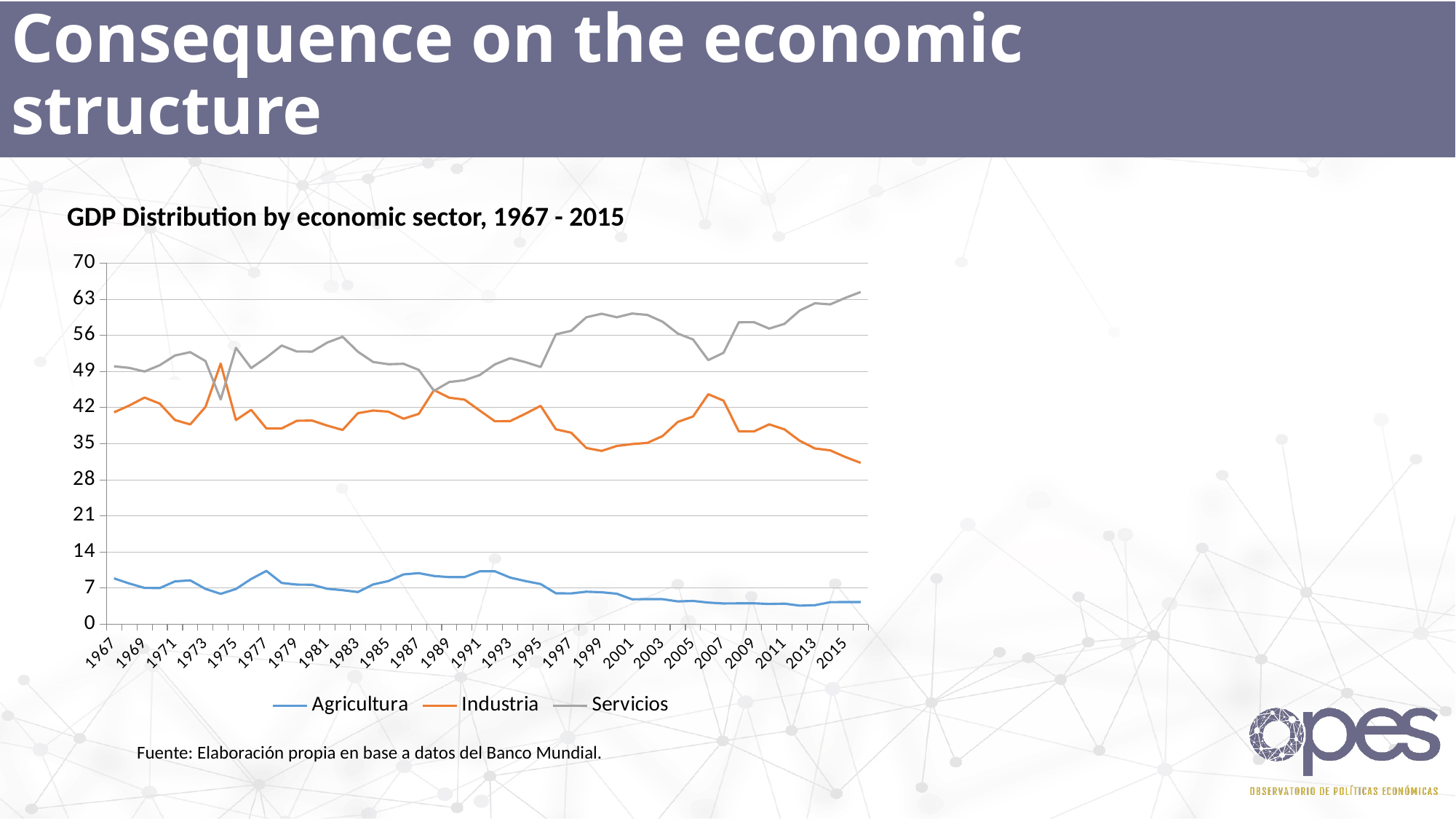
What is the title of the chart? GDP Distribution by economic sector, 1967 - 2015 What kind of chart is shown on the slide? line chart Is the value for Industria in 2015 greater or less than 35? less Which series has the highest value in 2015? Servicios Which series is shown in orange in the legend? Industria Is the value for Servicios in 2015 greater or less than 56? greater Does the Agricultura line generally rise or fall from 1991 to 2015? fall In 2007, which is larger: Industria or Servicios? Servicios How many series does the legend list? 3 Is the value for Agricultura in 2015 greater or less than 7? less Does the Servicios line generally rise or fall from 1967 to 2015? rise Which series has the lowest value across the whole period? Agricultura